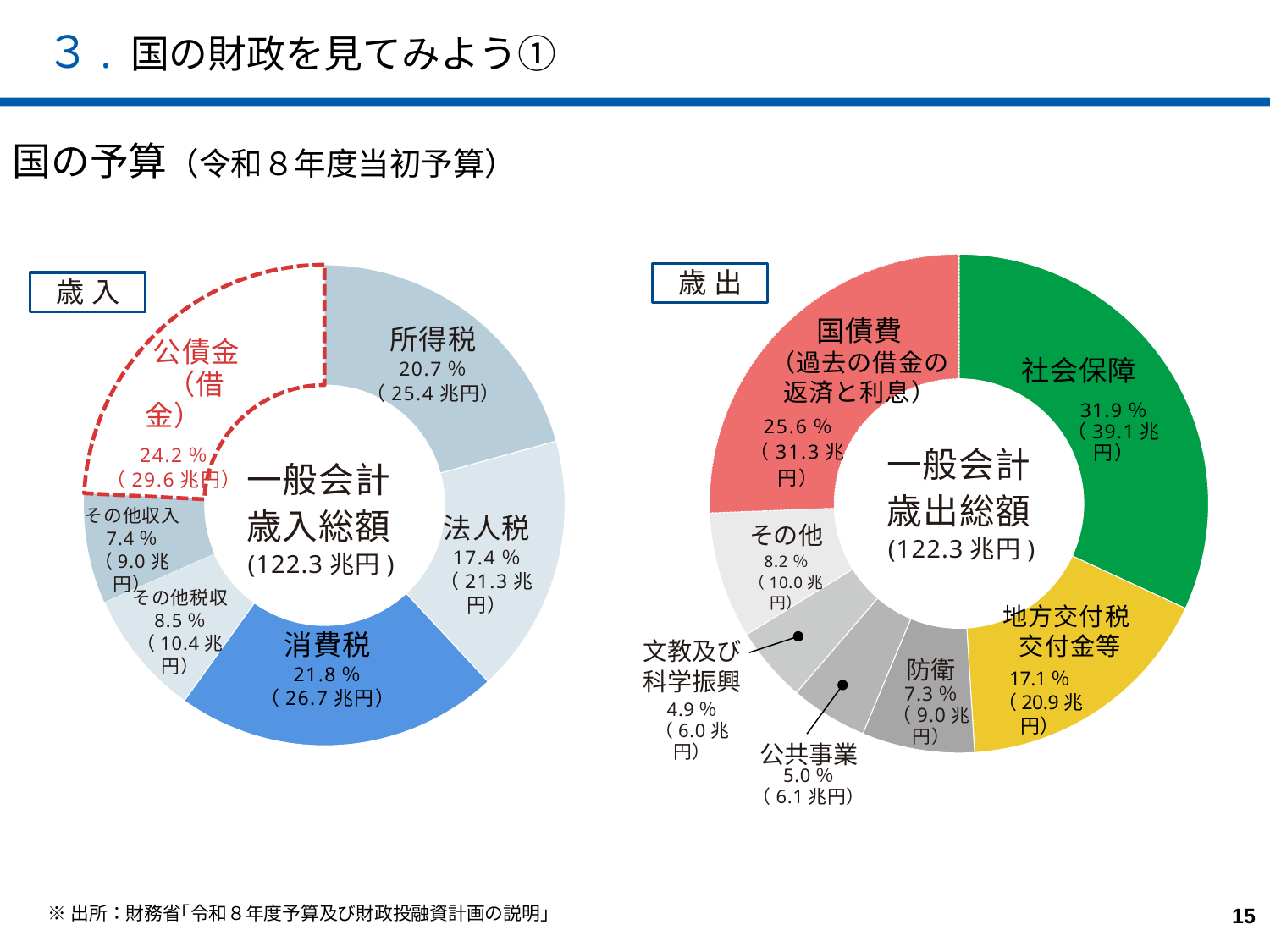
歳入のグラフで、所得税の割合は何％ですか？ 20.7% このスライドのグラフはどのような種類のグラフですか？ 円グラフ（ドーナツグラフ） 歳出のグラフで、最も割合が小さい項目はどれですか？ 文教及び科学振興 歳出のグラフで、最も割合が大きい項目はどれですか？ 社会保障 歳出のグラフで、国債費と地方交付税交付金等では、どちらの割合が大きいですか？ 国債費 歳出のグラフで、社会保障の金額はいくらですか？ 39.1兆円 歳入のグラフで、最も割合が小さい項目はどれですか？ その他収入 歳入のグラフで、一般会計歳入総額はいくらですか？ 122.3兆円 歳入のグラフで、最も割合が大きい項目はどれですか？ 公債金（借金） 歳入のグラフで、消費税と法人税の割合の差は何ポイントですか？ 4.4ポイント 歳出のグラフには、いくつの項目がありますか？ 7 歳入のグラフで、公債金（借金）の金額はいくらですか？ 29.6兆円